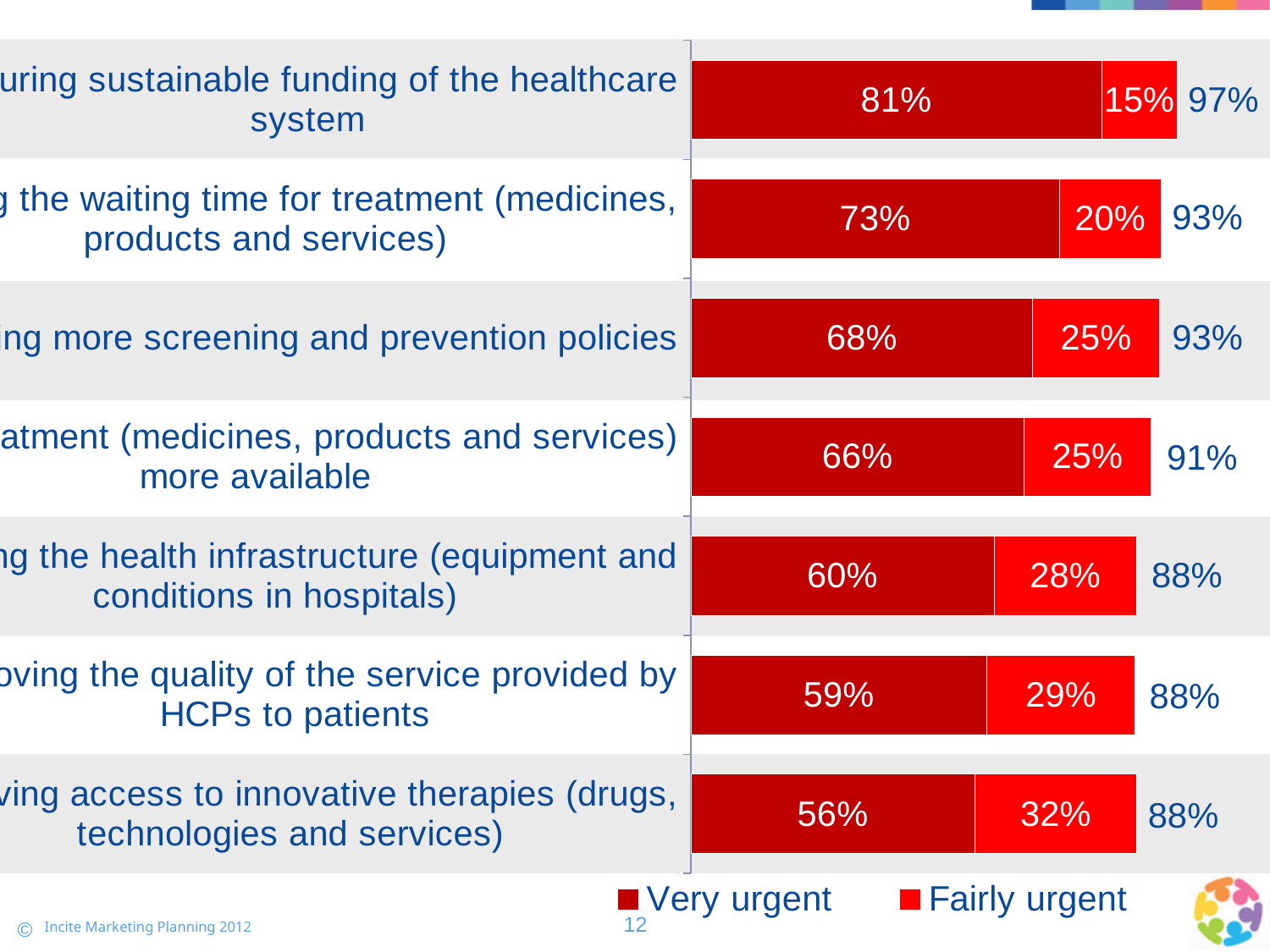
How many series does the legend list? 2 What is the 'Very urgent' value for access to innovative therapies (drugs, technologies and services)? 56% Which is larger: the 'Fairly urgent' value for the waiting time for treatment or the 'Fairly urgent' value for access to innovative therapies? access to innovative therapies How many categories (bars) are plotted in the chart? 7 Which category has the highest 'Very urgent' value? sustainable funding of the healthcare system What is the 'Very urgent' value for sustainable funding of the healthcare system? 81% Which legend entry is shown in dark red? Very urgent What kind of chart is shown on the slide? stacked bar chart What is the 'Fairly urgent' value for the health infrastructure (equipment and conditions in hospitals)? 28% What total is shown at the end of the bar for sustainable funding of the healthcare system? 97% Which category has the lowest 'Fairly urgent' value? sustainable funding of the healthcare system What is the difference between the 'Very urgent' values for screening and prevention policies and for the quality of the service provided by HCPs to patients? 9%